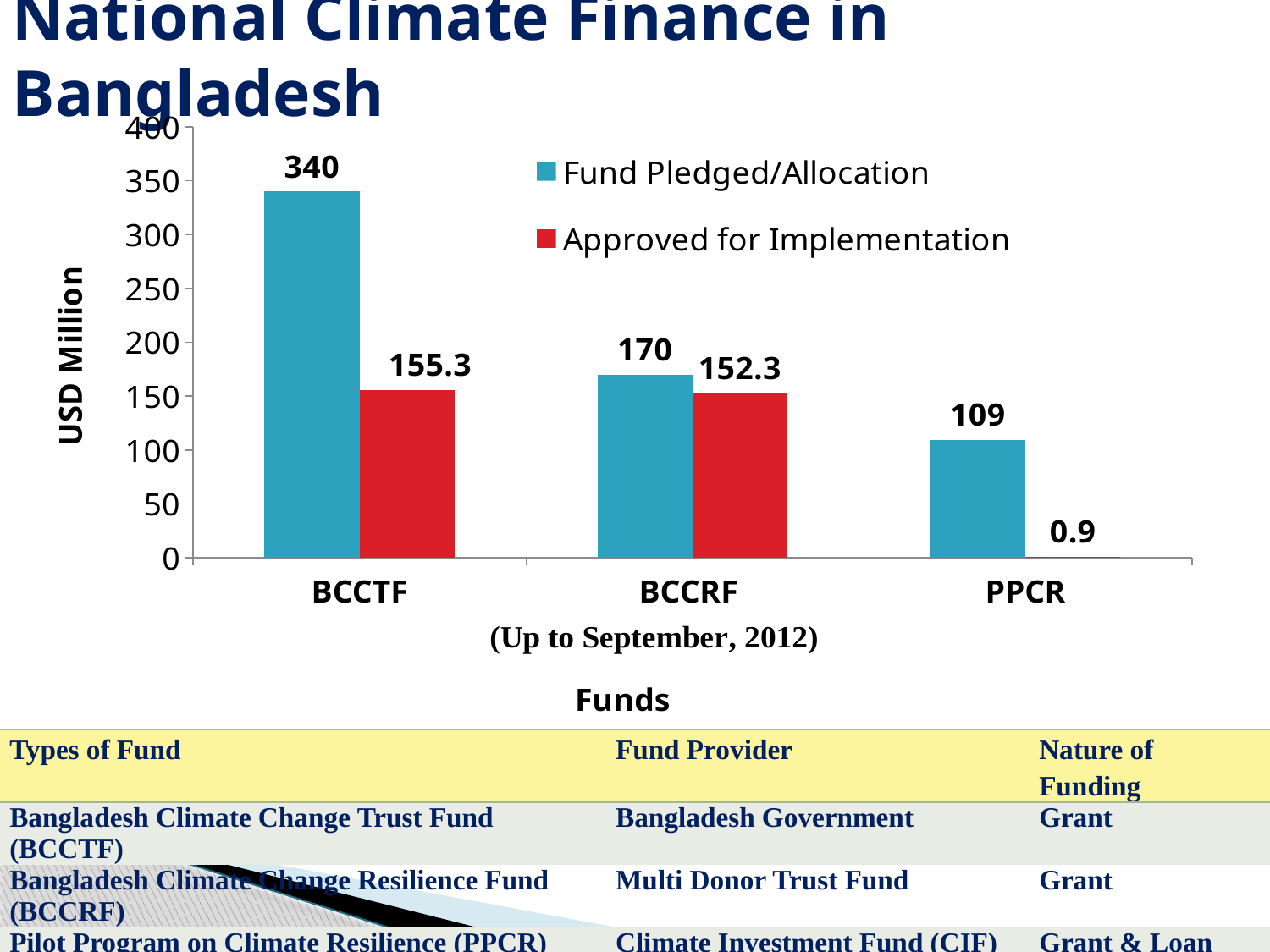
How many funds are shown on the x axis of the chart? 3 Which is larger: the Approved for Implementation value for BCCTF or for BCCRF? BCCTF What is the Approved for Implementation value for BCCRF? 152.3 How many series does the chart legend list? 2 What kind of chart is shown on the slide? Bar chart What is the Fund Pledged/Allocation value for BCCTF? 340 What is the Approved for Implementation value for PPCR? 0.9 Which fund has the lowest Approved for Implementation value? PPCR What is the difference between Fund Pledged/Allocation and Approved for Implementation for BCCRF? 17.7 What is the label of the y axis of the chart? USD Million Which fund has the highest Fund Pledged/Allocation value? BCCTF What is the difference between Fund Pledged/Allocation and Approved for Implementation for BCCTF? 184.7